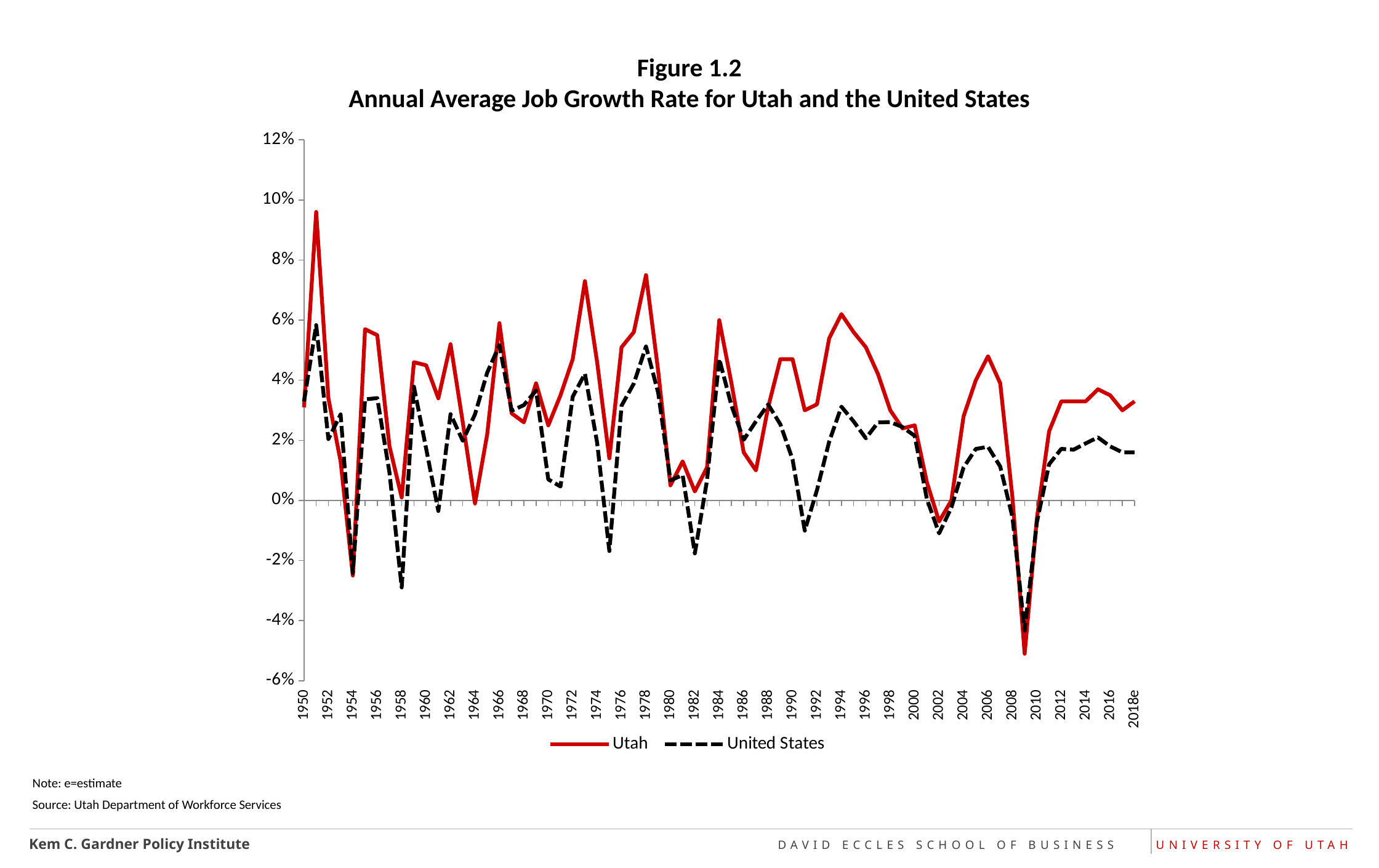
Does the Utah job growth rate rise or fall from 2009 to 2012? rise Is the Utah job growth rate in 1951 greater or less than 8%? greater Which series is drawn with a dashed line? United States How many series does the legend list? 2 In 1994, which had the higher job growth rate, Utah or the United States? Utah In which year does the Utah line reach its highest value? 1951 Is the United States job growth rate in 1958 greater or less than -2%? less Is the United States job growth rate in 2018e greater or less than 2%? less What is the title of the chart? Annual Average Job Growth Rate for Utah and the United States What kind of chart is shown on the slide? line chart